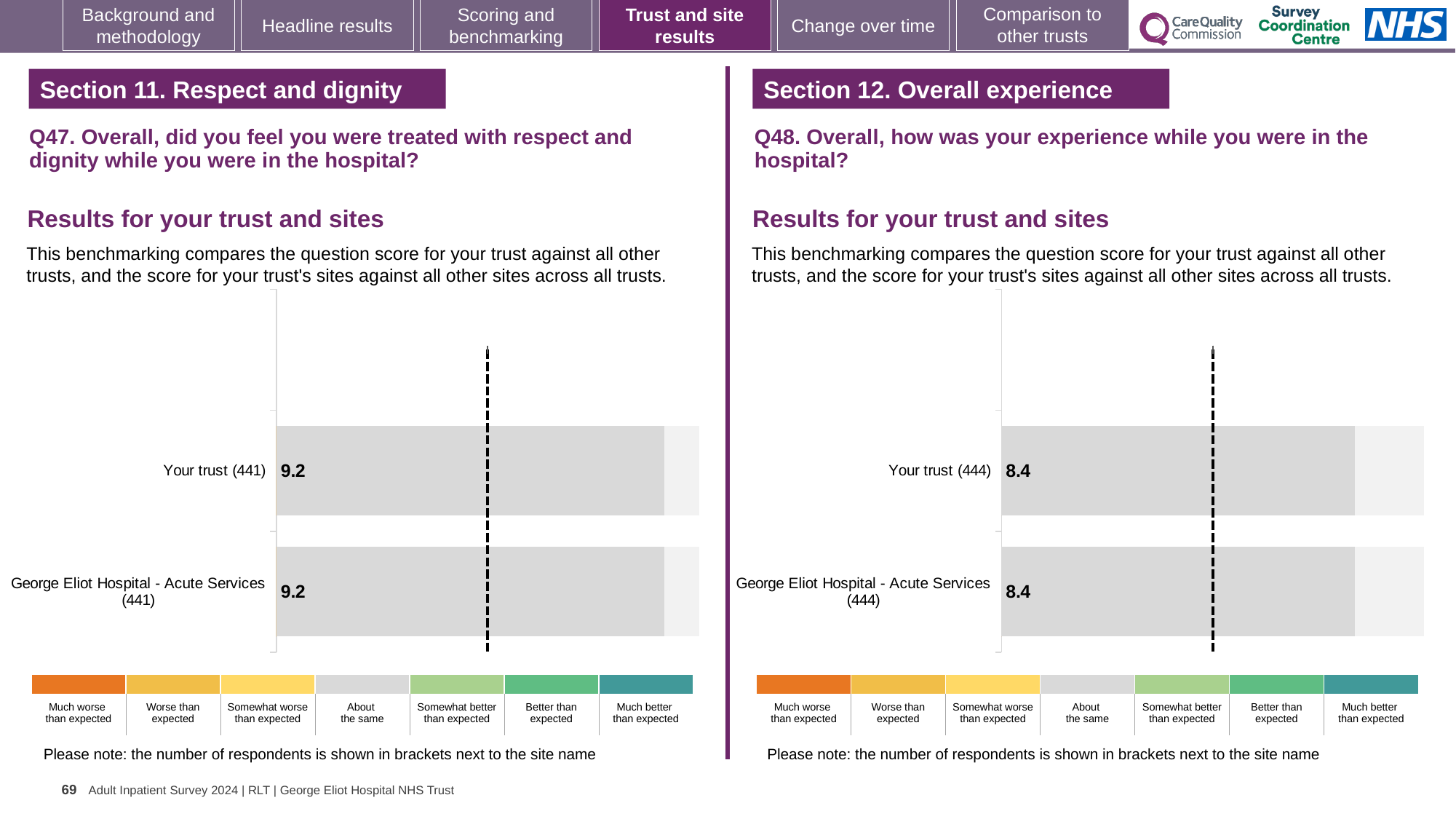
Is the score for Your trust on the Q47 chart (Section 11. Respect and dignity) larger or smaller than the score for Your trust on the Q48 chart (Section 12. Overall experience)? Larger On the Q47 chart (Section 11. Respect and dignity), what is the difference between the score for Your trust and the score for George Eliot Hospital - Acute Services? 0 On the Q47 chart (Section 11. Respect and dignity), what is the score for George Eliot Hospital - Acute Services? 9.2 On the Q48 chart (Section 12. Overall experience), how many respondents are shown in brackets next to George Eliot Hospital - Acute Services? 444 On the Q47 chart (Section 11. Respect and dignity), how many respondents are shown in brackets next to Your trust? 441 What kind of chart is used on the Q47 chart (Section 11. Respect and dignity)? Bar chart On the Q48 chart (Section 12. Overall experience), what is the score for Your trust? 8.4 On the Q48 chart (Section 12. Overall experience), what is the score for George Eliot Hospital - Acute Services? 8.4 How many bars are plotted on the Q47 chart (Section 11. Respect and dignity)? 2 On the Q47 chart (Section 11. Respect and dignity), what is the score for Your trust? 9.2 On the Q48 chart (Section 12. Overall experience), what is the difference between the score for Your trust and the score for George Eliot Hospital - Acute Services? 0 How many bars are plotted on the Q48 chart (Section 12. Overall experience)? 2